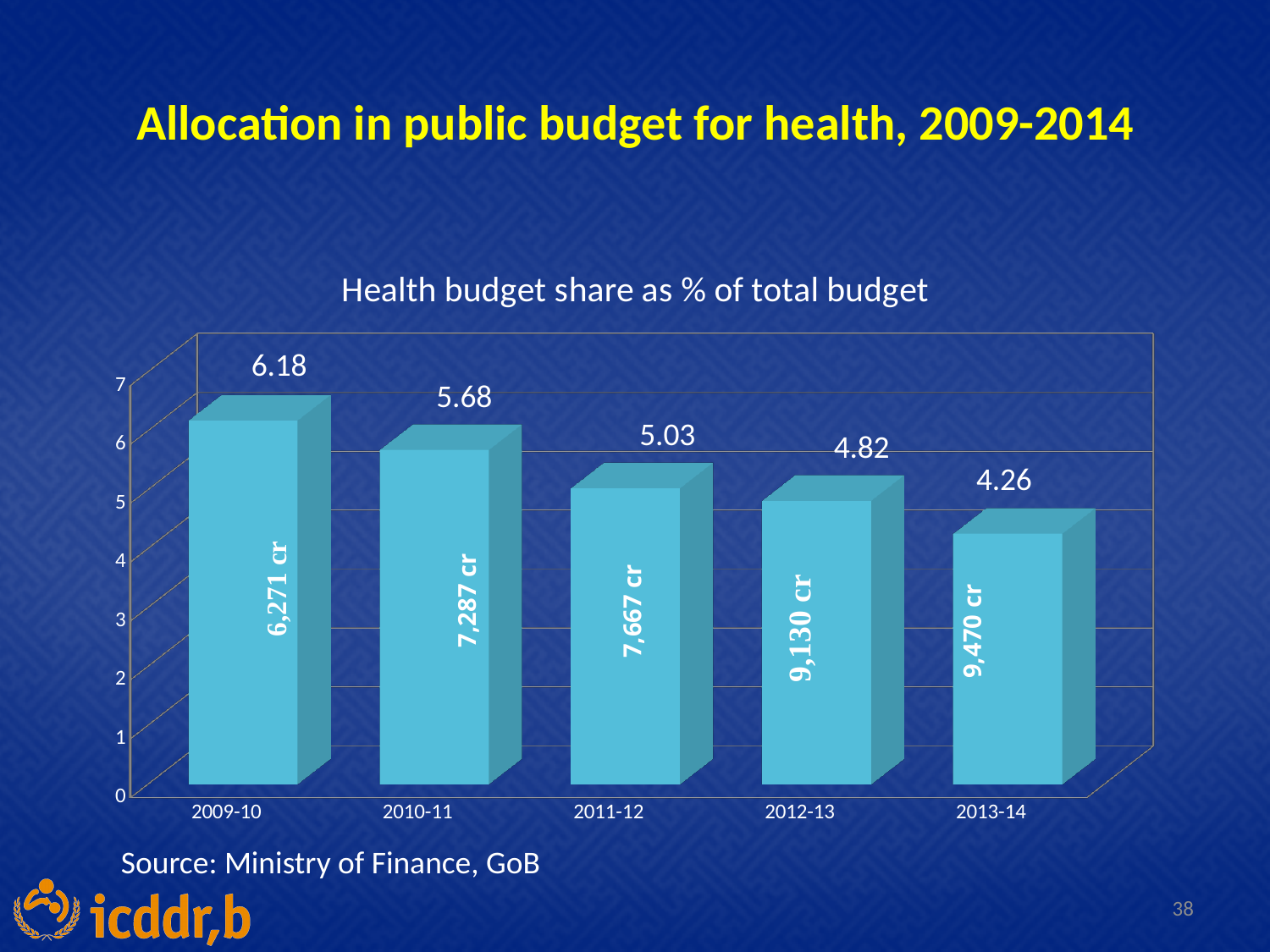
What kind of chart is shown on the slide? Bar chart How many years are shown on the chart? 5 Which year has a larger health budget share, 2010-11 or 2012-13? 2010-11 What is the health budget share as % of total budget for 2009-10? 6.18 What allocation amount in crore is printed on the bar for 2010-11? 7,287 cr Does the health budget share as % of total budget rise or fall from 2009-10 to 2013-14? Fall Which year has the highest health budget share as % of total budget? 2009-10 What is the health budget share as % of total budget for 2013-14? 4.26 What is the difference in health budget share between 2009-10 and 2013-14? 1.92 What is the health budget share as % of total budget for 2011-12? 5.03 What allocation amount in crore is printed on the bar for 2012-13? 9,130 cr Which year has the lowest health budget share as % of total budget? 2013-14